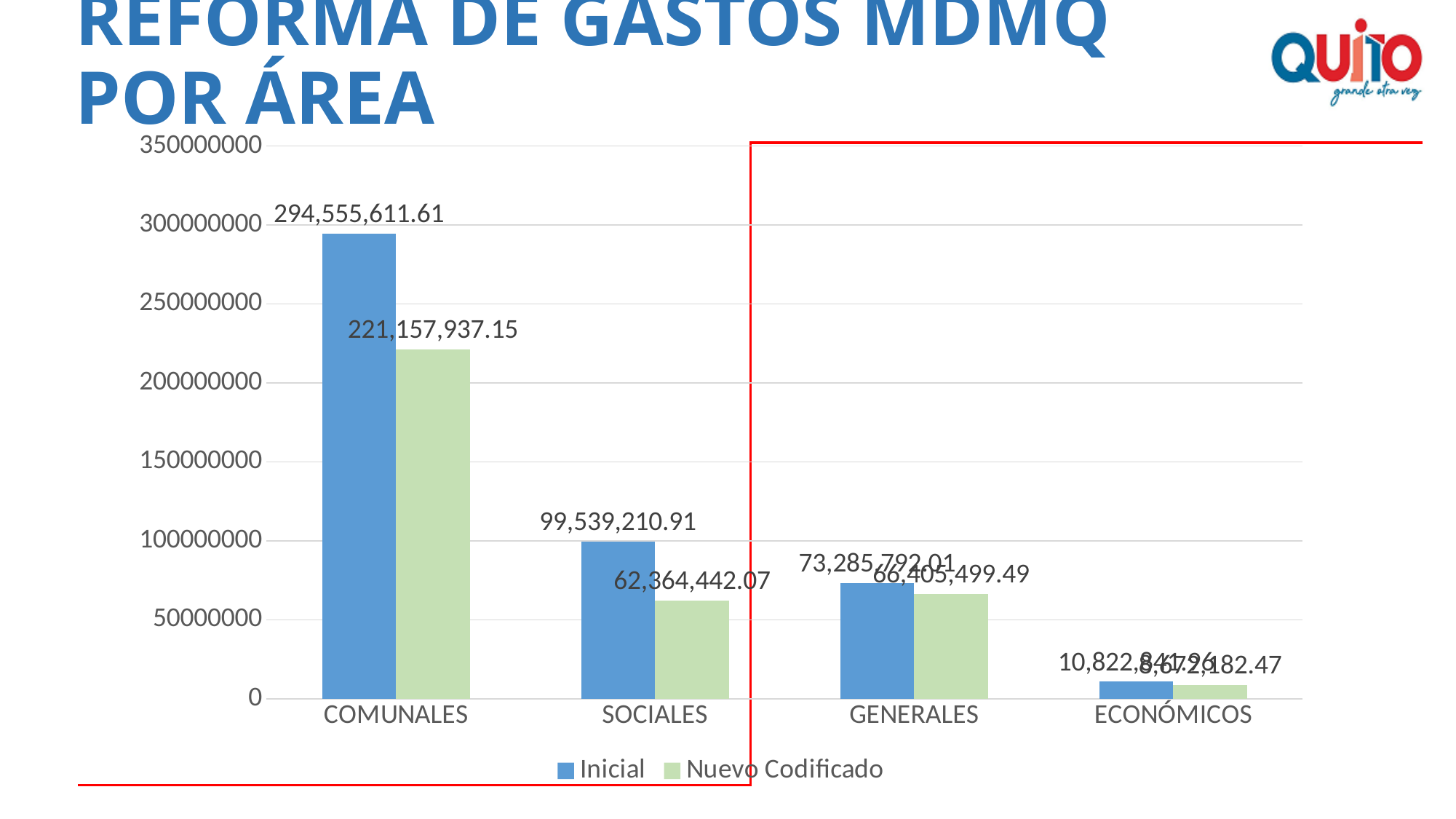
Is the Inicial value for ECONÓMICOS greater or less than 50000000? less What is the difference between the Inicial and Nuevo Codificado values for COMUNALES? 73,397,674.46 What is the Inicial value for COMUNALES? 294,555,611.61 Which category has the lowest Nuevo Codificado value? ECONÓMICOS Which category has the highest Inicial value? COMUNALES What is the Nuevo Codificado value for COMUNALES? 221,157,937.15 What is the Nuevo Codificado value for GENERALES? 66,405,499.49 What is the Inicial value for SOCIALES? 99,539,210.91 Do the Inicial values rise or fall from COMUNALES to ECONÓMICOS? fall How many series does the legend list? 2 Which is larger for GENERALES, the Inicial value or the Nuevo Codificado value? Inicial What is the difference between the Inicial and Nuevo Codificado values for SOCIALES? 37,174,768.84